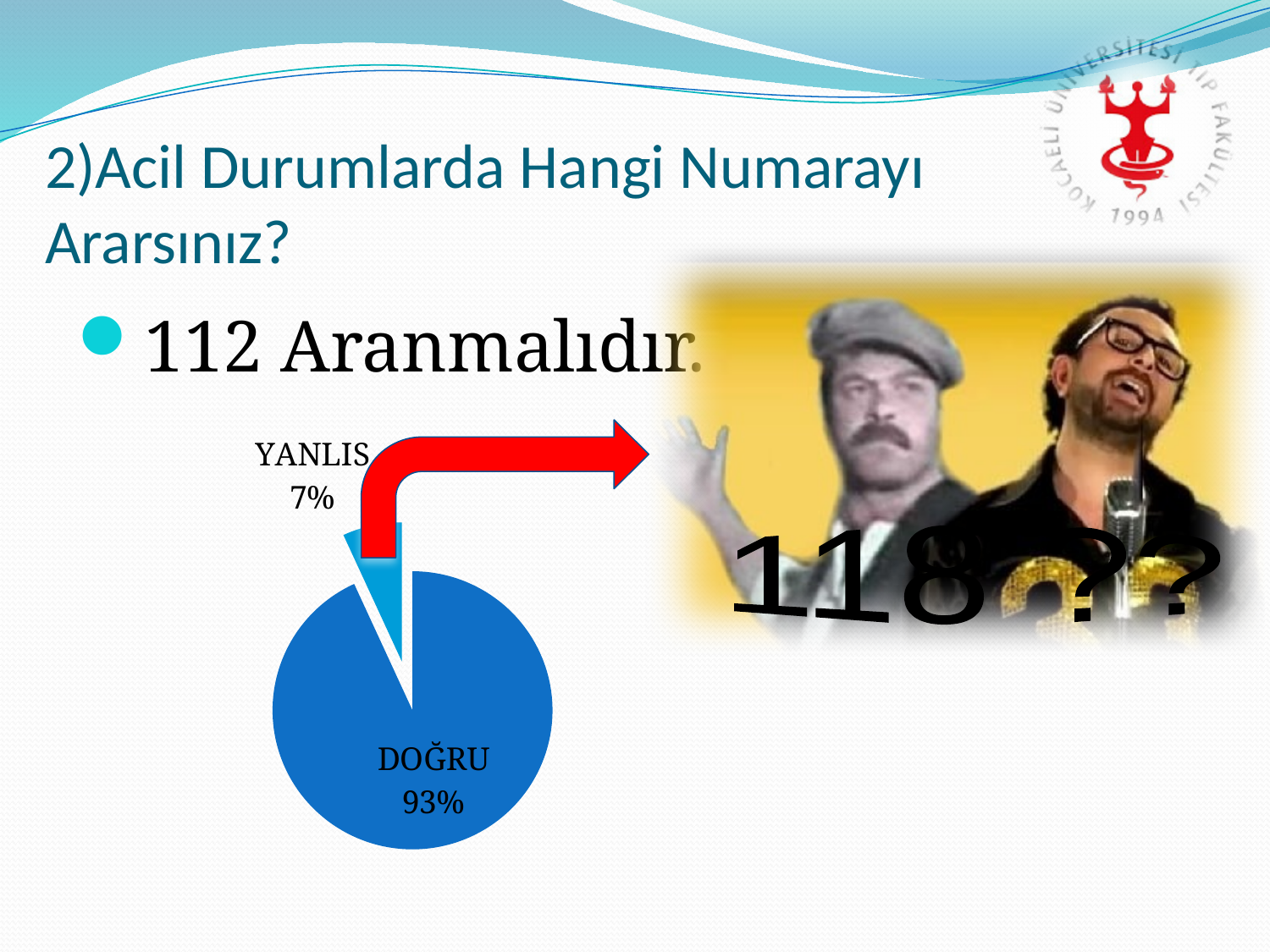
What is the difference in percentage points between the DOĞRU and YANLIS slices? 86 What share of the pie does the YANLIS slice represent? 7% Which slice of the pie chart is the largest? DOĞRU What kind of chart is shown on the slide? pie chart What percentage is shown for DOĞRU in the pie chart? 93% Which slice of the pie chart is the smallest? YANLIS Is the value for DOĞRU greater or less than 50%? greater What colour is the DOĞRU slice of the pie chart? blue Which is larger in the pie chart, DOĞRU or YANLIS? DOĞRU What percentage is shown for YANLIS in the pie chart? 7% How many slices does the pie chart have? 2